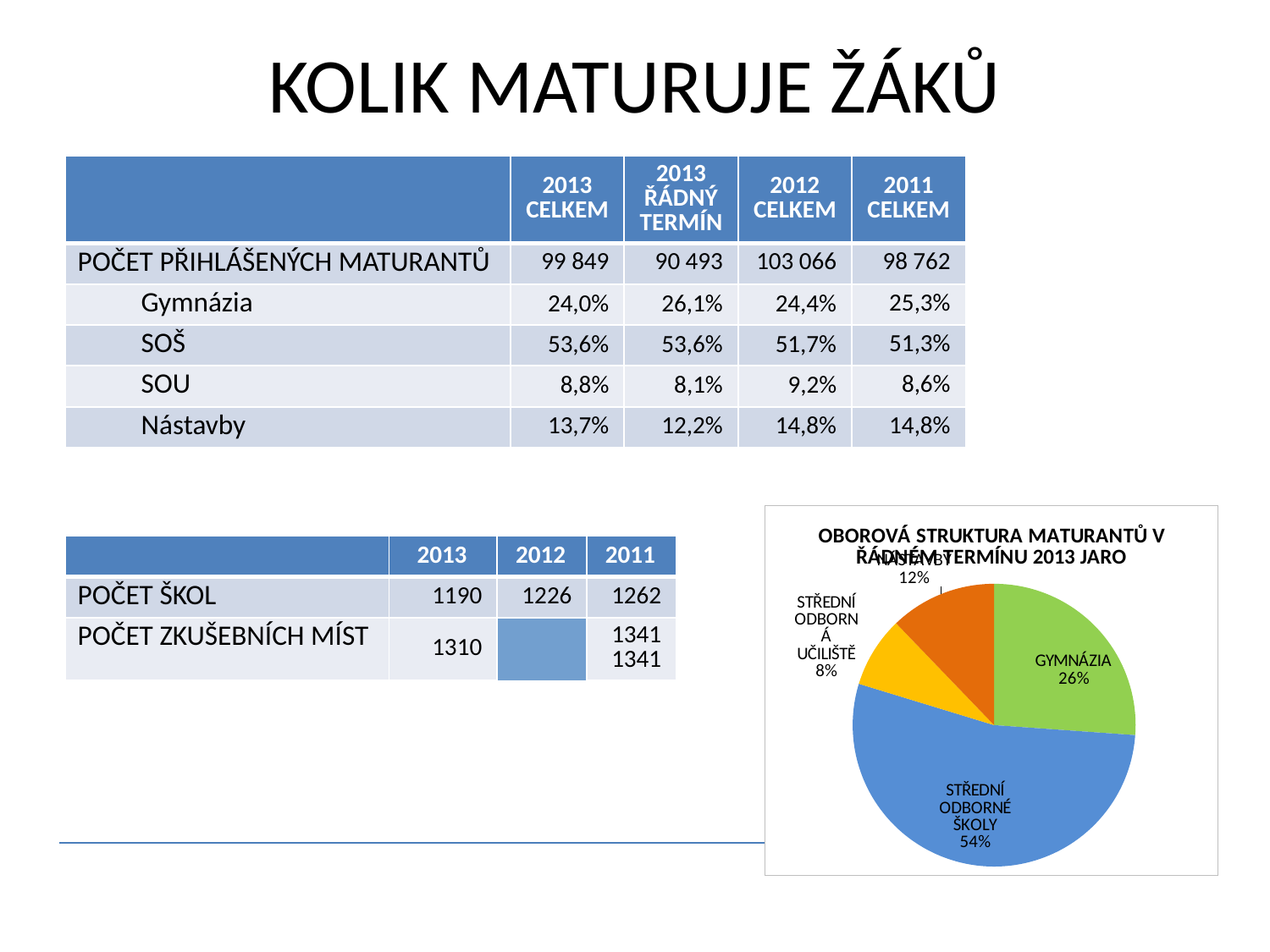
Which slice of the pie chart is the smallest? STŘEDNÍ ODBORNÁ UČILIŠTĚ In the pie chart, which is larger: GYMNÁZIA or NÁSTAVBY? GYMNÁZIA In the pie chart, what share do STŘEDNÍ ODBORNÉ ŠKOLY have? 54% What colour is the STŘEDNÍ ODBORNÉ ŠKOLY slice in the pie chart? blue What kind of chart is shown on the slide? pie chart How many slices does the pie chart have? 4 In the pie chart, what share do GYMNÁZIA have? 26% Which slice of the pie chart is the largest? STŘEDNÍ ODBORNÉ ŠKOLY In the pie chart, what share do STŘEDNÍ ODBORNÁ UČILIŠTĚ have? 8% What is the title of the pie chart? OBOROVÁ STRUKTURA MATURANTŮ V ŘÁDNÉM TERMÍNU 2013 JARO In the pie chart, what is the difference in percentage points between STŘEDNÍ ODBORNÉ ŠKOLY and GYMNÁZIA? 28